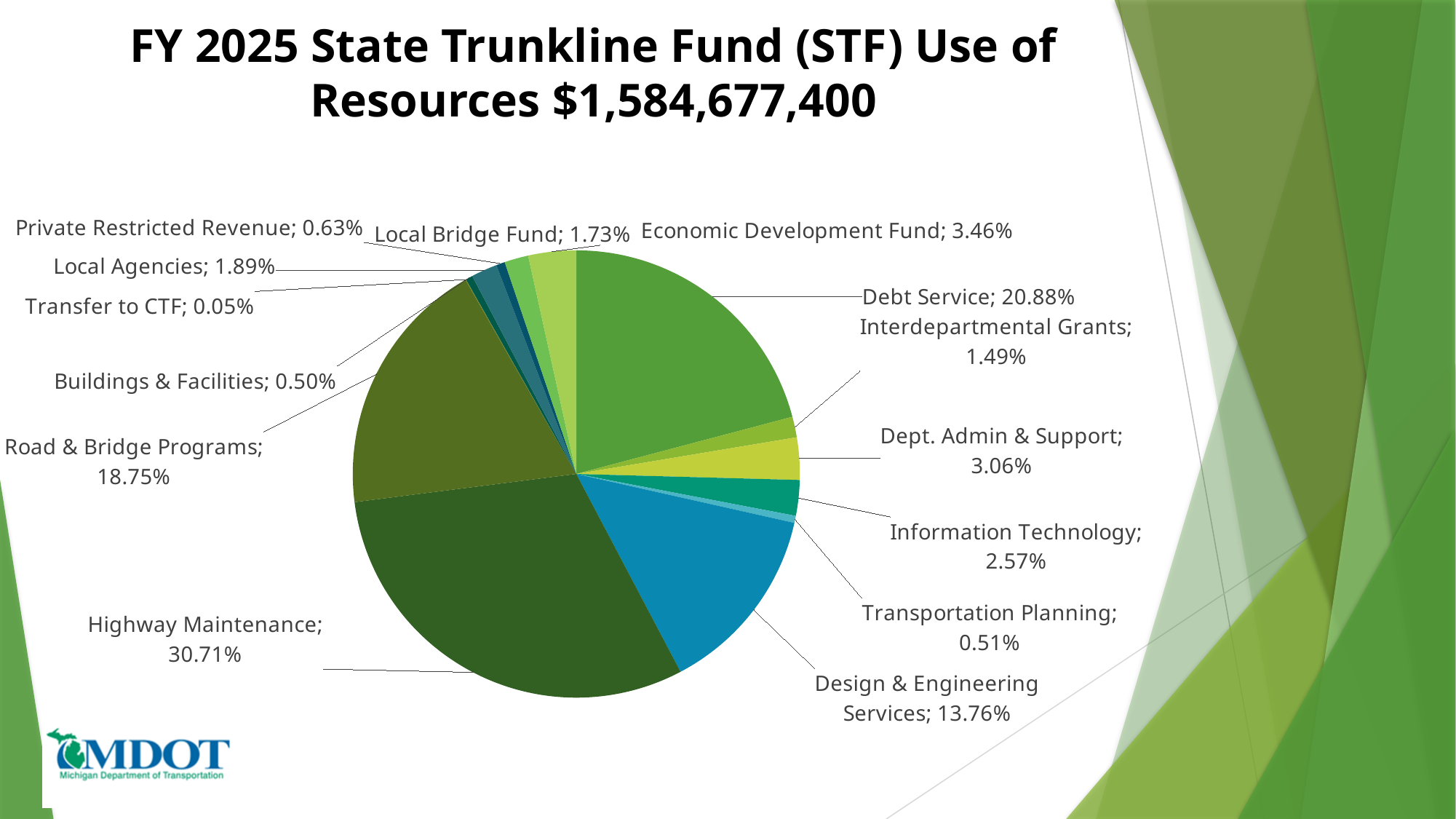
Which category has the smallest share of the pie? Transfer to CTF What share of the FY 2025 STF use of resources goes to Highway Maintenance? 30.71% What is the difference in percentage points between Highway Maintenance and Debt Service? 9.83 Which category has the largest share of the pie? Highway Maintenance Which is larger, the share for Economic Development Fund or the share for Dept. Admin & Support? Economic Development Fund What percentage is shown for Debt Service? 20.88% How many categories are shown in the pie chart? 14 What percentage is shown for Design & Engineering Services? 13.76% What is the difference in percentage points between Road & Bridge Programs and Design & Engineering Services? 4.99 What percentage is shown for Transfer to CTF? 0.05% What total dollar amount is given in the chart title? $1,584,677,400 What type of chart is shown on the slide? Pie chart